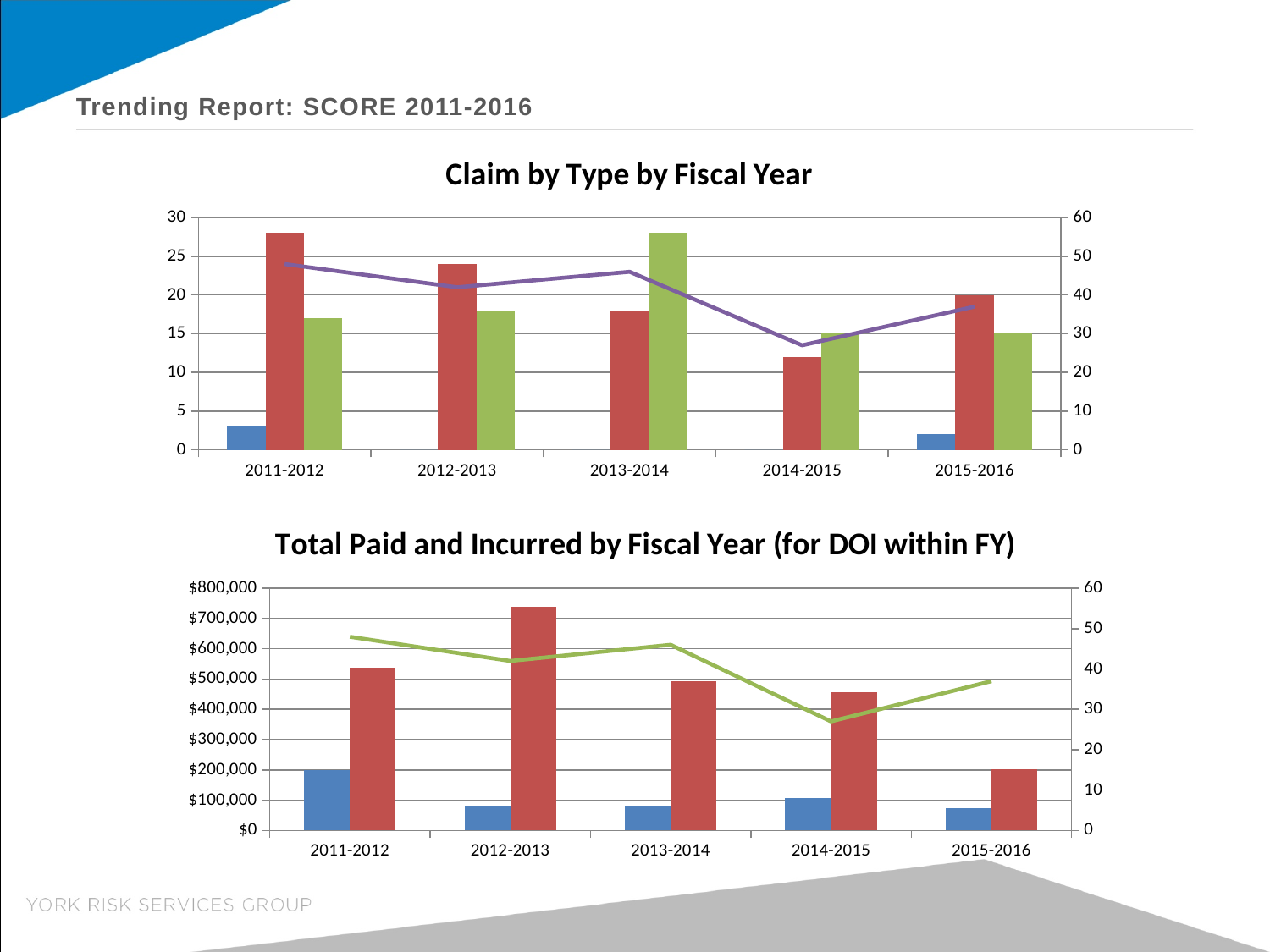
In the 'Total Paid and Incurred by Fiscal Year' chart, at which fiscal year does the line reach its lowest point? 2014-2015 What kind of chart is the 'Claim by Type by Fiscal Year' chart? bar chart with a line How many fiscal years are shown on the x axis of the 'Total Paid and Incurred by Fiscal Year' chart? 5 In the 'Claim by Type by Fiscal Year' chart, is the red bar for 2014-2015 greater or less than 15 on the left axis? less In the 'Total Paid and Incurred by Fiscal Year' chart, is the red bar for 2015-2016 greater or less than $300,000? less In the 'Claim by Type by Fiscal Year' chart, which is taller for 2013-2014, the red bar or the green bar? the green bar What is the highest value shown on the left axis of the 'Total Paid and Incurred by Fiscal Year' chart? $800,000 In the 'Claim by Type by Fiscal Year' chart, is the red bar for 2011-2012 greater or less than 25 on the left axis? greater In the 'Total Paid and Incurred by Fiscal Year' chart, which fiscal year has the tallest red bar? 2012-2013 In the 'Claim by Type by Fiscal Year' chart, does the line rise or fall from 2011-2012 to 2014-2015? fall How many fiscal years are shown on the x axis of the 'Claim by Type by Fiscal Year' chart? 5